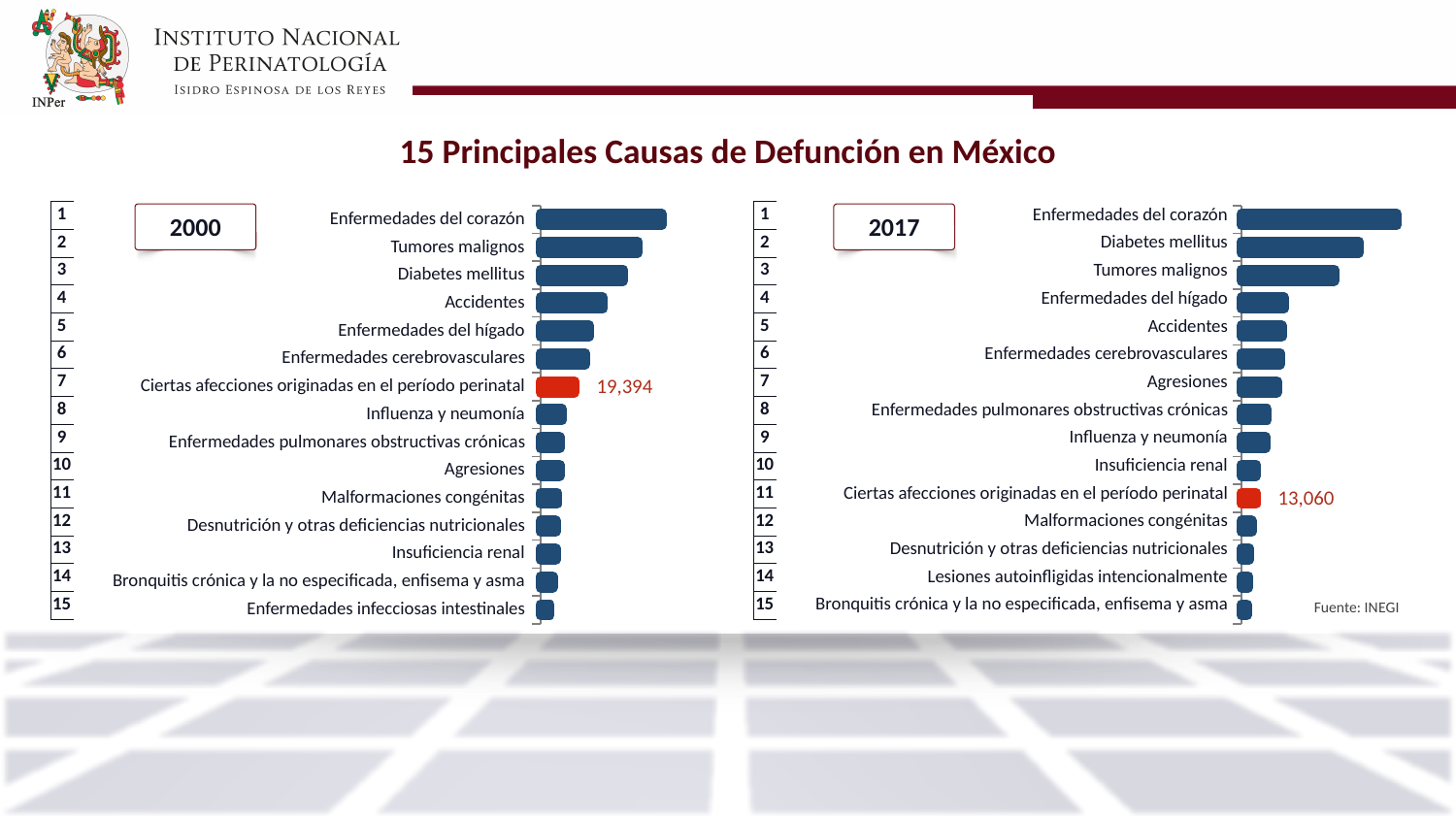
In the 2017 chart, what rank does 'Ciertas afecciones originadas en el período perinatal' hold? 11 In the 2017 chart, which cause of death has the shortest bar? Bronquitis crónica y la no especificada, enfisema y asma In the 2017 chart, which has the longer bar: Diabetes mellitus or Tumores malignos? Diabetes mellitus What is the difference between the labelled perinatal values in the 2000 chart and the 2017 chart? 6,334 How many causes of death are listed in the 2017 chart? 15 In the 2000 chart, which cause of death has the shortest bar? Enfermedades infecciosas intestinales In the 2000 chart, which cause of death has the longest bar? Enfermedades del corazón What type of chart is the 2000 chart? Bar chart In the 2017 chart, what value is labelled for 'Ciertas afecciones originadas en el período perinatal'? 13,060 In the 2017 chart, which cause of death has the longest bar? Enfermedades del corazón In the 2000 chart, which has the longer bar: Tumores malignos or Accidentes? Tumores malignos In the 2000 chart, what value is labelled for 'Ciertas afecciones originadas en el período perinatal'? 19,394